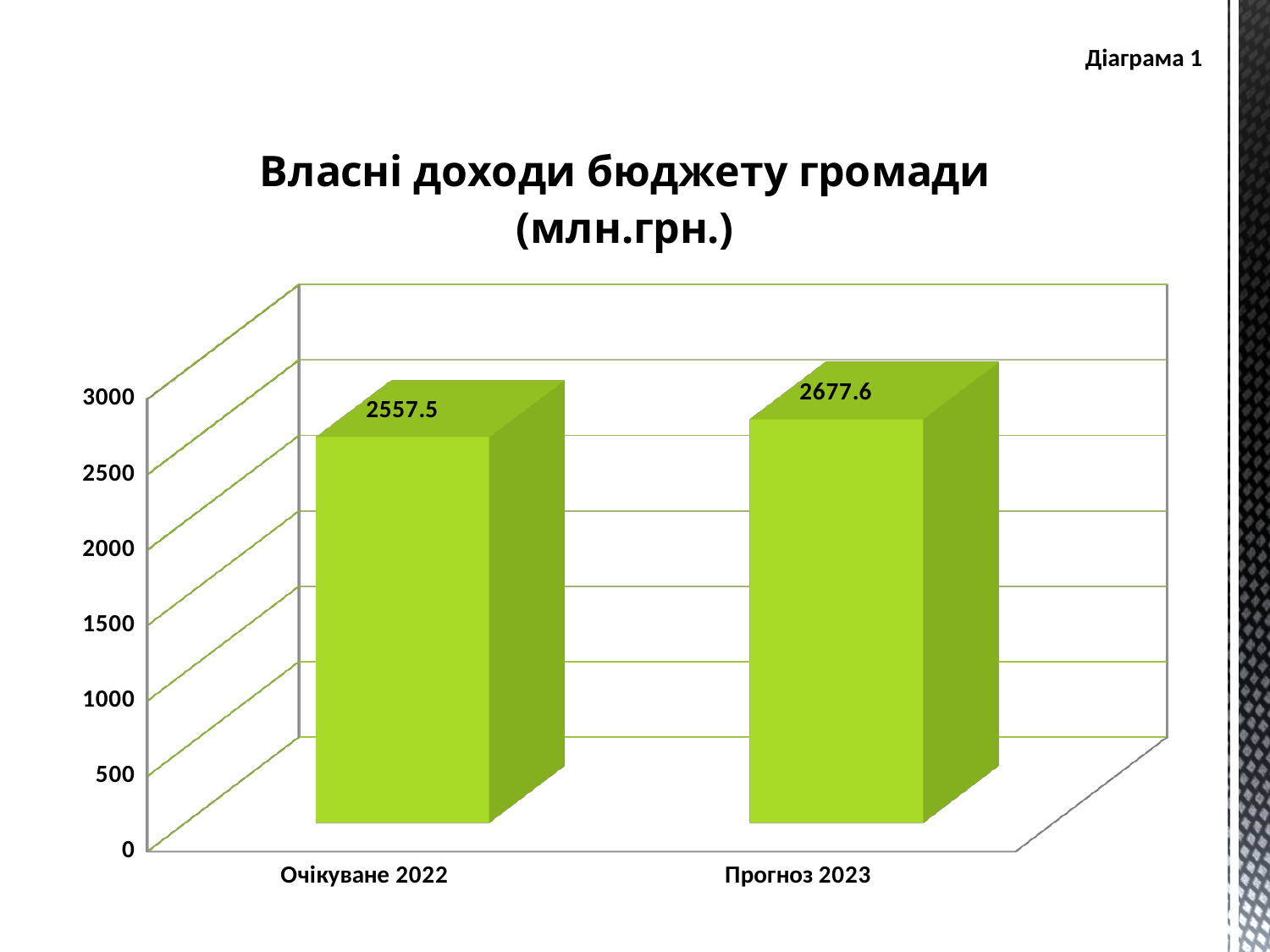
What is the title of the chart? Власні доходи бюджету громади (млн.грн.) Which is larger, the value for Очікуване 2022 or the value for Прогноз 2023? Прогноз 2023 What is the value for Прогноз 2023? 2677.6 What is the value for Очікуване 2022? 2557.5 Is the value for Прогноз 2023 greater or less than 3000? less Is the value for Очікуване 2022 greater or less than 2000? greater How many categories are shown on the x axis? 2 What kind of chart is shown on the slide? bar chart Do the values rise or fall from Очікуване 2022 to Прогноз 2023? rise Which category has the lowest value? Очікуване 2022 Which category has the highest value? Прогноз 2023 What is the difference between the values for Прогноз 2023 and Очікуване 2022? 120.1